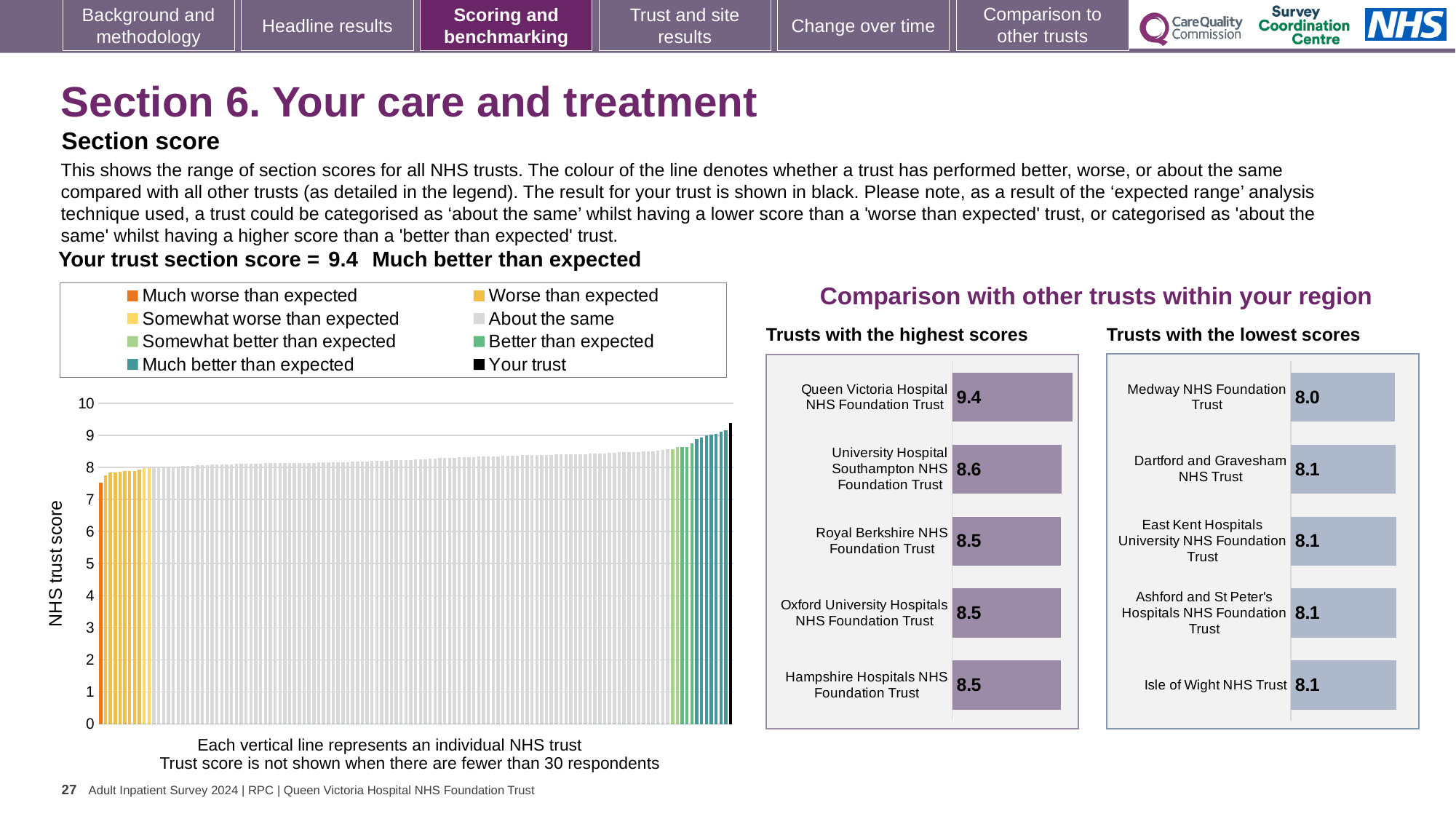
In the large chart on the left showing all NHS trusts, is the value for the black 'Your trust' bar greater or less than 9? greater Which is larger: the score for Queen Victoria Hospital NHS Foundation Trust in the highest-scores chart or the score for Medway NHS Foundation Trust in the lowest-scores chart? Queen Victoria Hospital NHS Foundation Trust In the 'Trusts with the highest scores' chart, what is the score for Queen Victoria Hospital NHS Foundation Trust? 9.4 In the 'Trusts with the highest scores' chart, what is the score for University Hospital Southampton NHS Foundation Trust? 8.6 How many entries does the legend of the large chart on the left list? 8 In the 'Trusts with the lowest scores' chart, which trust has the lowest score? Medway NHS Foundation Trust In the 'Trusts with the lowest scores' chart, what is the score for Medway NHS Foundation Trust? 8.0 In the 'Trusts with the lowest scores' chart, what is the score for Isle of Wight NHS Trust? 8.1 In the 'Trusts with the highest scores' chart, which trust has the highest score? Queen Victoria Hospital NHS Foundation Trust In the 'Trusts with the highest scores' chart, what is the difference between the scores of Queen Victoria Hospital NHS Foundation Trust and University Hospital Southampton NHS Foundation Trust? 0.8 How many trusts are shown in the 'Trusts with the highest scores' chart? 5 In the large chart on the left showing all NHS trusts, do the bar values rise or fall from left to right? rise